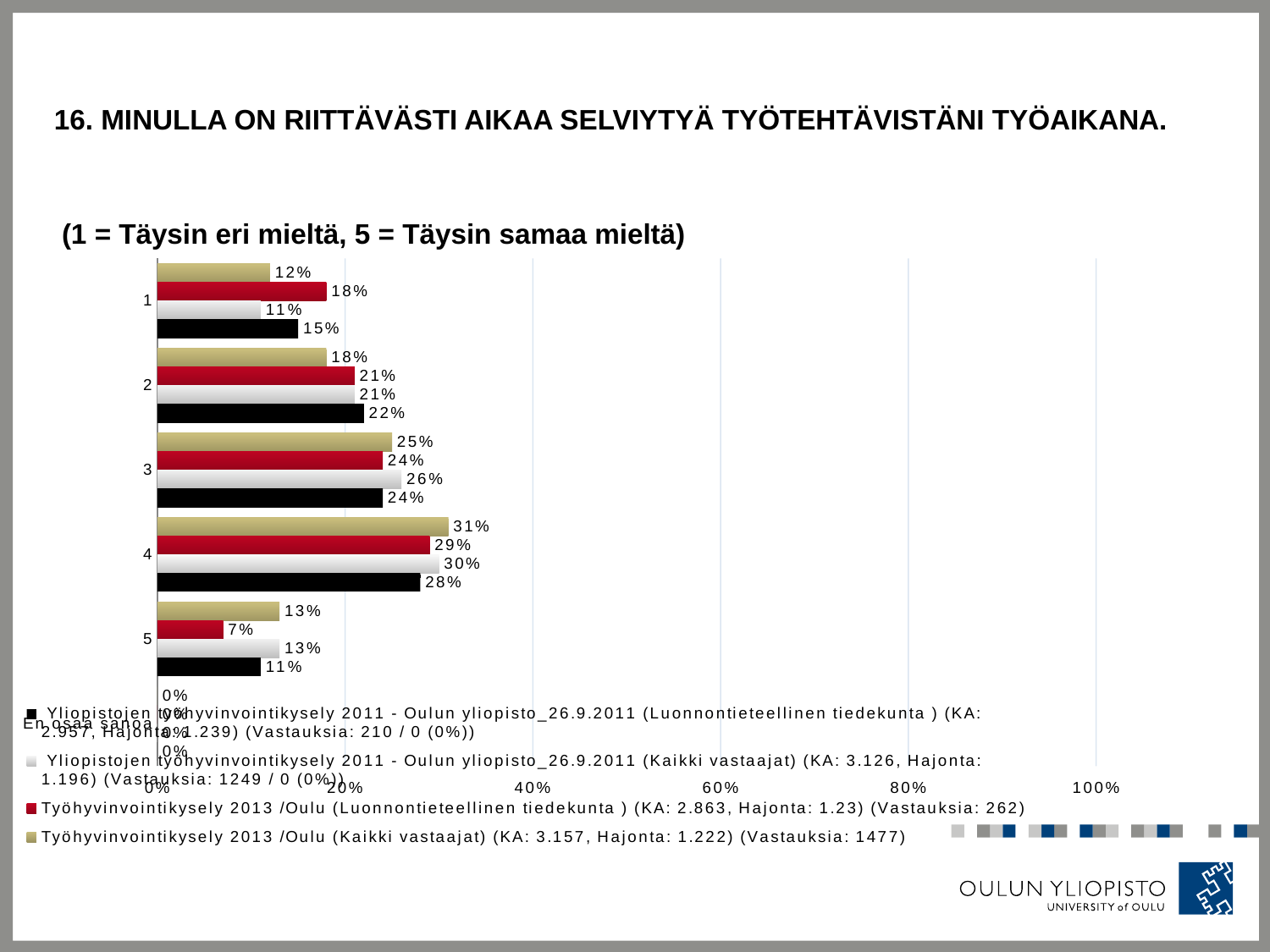
Which category has the highest value in the series Työhyvinvointikysely 2013 /Oulu (Kaikki vastaajat)? 4 What is the value for category 5 in the series Työhyvinvointikysely 2013 /Oulu (Luonnontieteellinen tiedekunta)? 7% What is the value for category 3 in the series Yliopistojen työhyvinvointikysely 2011 - Oulun yliopisto (Kaikki vastaajat)? 26% How many series does the legend list? 4 Is the value for category 4 in Työhyvinvointikysely 2013 /Oulu (Kaikki vastaajat) greater or less than 20%? greater How many categories are shown on the vertical axis of the chart? 6 In category 2, which is larger: Yliopistojen työhyvinvointikysely 2011 (Luonnontieteellinen tiedekunta) or Työhyvinvointikysely 2013 /Oulu (Kaikki vastaajat)? Yliopistojen työhyvinvointikysely 2011 (Luonnontieteellinen tiedekunta) Among categories 1 to 5, which has the lowest value in the series Työhyvinvointikysely 2013 /Oulu (Luonnontieteellinen tiedekunta)? 5 What is the value for category 2 in the series Yliopistojen työhyvinvointikysely 2011 - Oulun yliopisto (Luonnontieteellinen tiedekunta)? 22% In category 1, what is the difference between Työhyvinvointikysely 2013 /Oulu (Luonnontieteellinen tiedekunta) and Yliopistojen työhyvinvointikysely 2011 (Kaikki vastaajat)? 7 percentage points What kind of chart is shown on the slide? bar chart What is the value for category 4 in the series Työhyvinvointikysely 2013 /Oulu (Kaikki vastaajat)? 31%